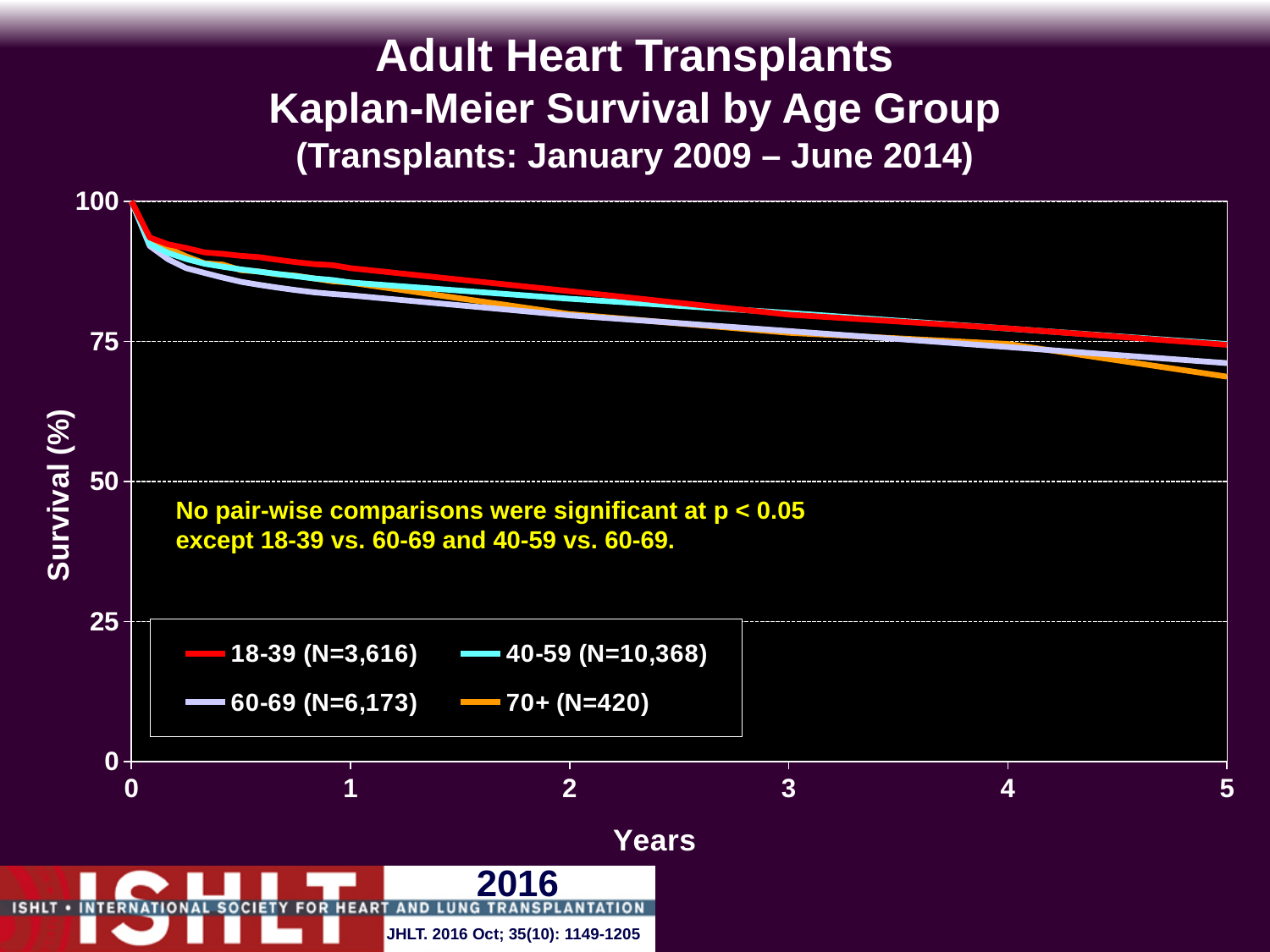
How many tick marks are labelled on the Years axis? 6 Which colour represents the 40-59 age group in the legend? cyan Is the survival for the 70+ group at 5 years greater or less than 75? less Which age group has the lowest survival at 5 years? 70+ Is the survival for the 18-39 group at 2 years greater or less than 75? greater How many series does the legend list? 4 Is the survival for the 60-69 group at 1 year greater or less than 75? greater Which age group has the highest survival at 1 year? 18-39 At 5 years, which group has higher survival: 18-39 or 70+? 18-39 What kind of chart is shown on the slide? line chart What is the N shown in the legend for the 70+ group? N=420 Do the survival curves rise or fall as years increase? fall